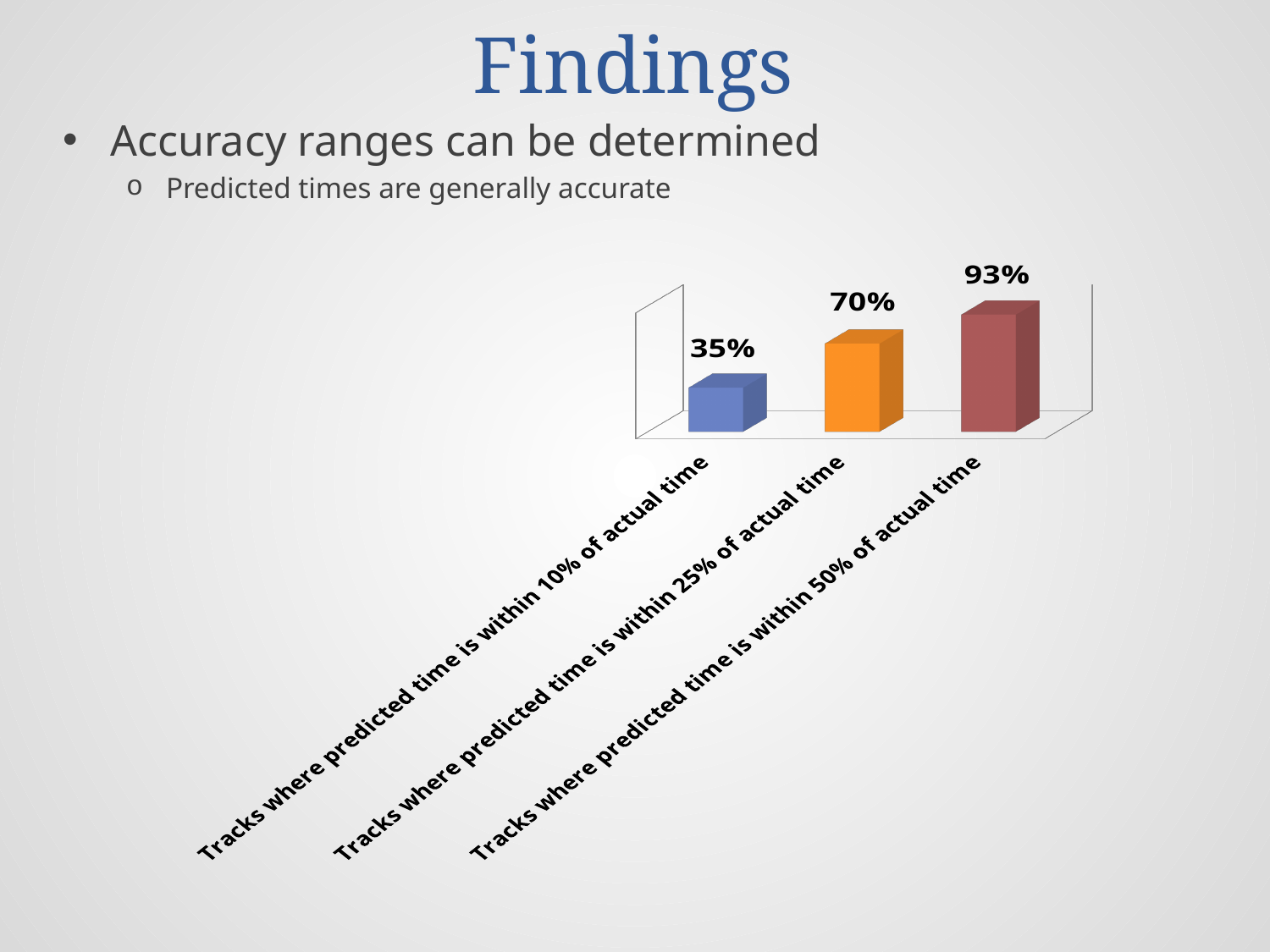
Which is larger: the value for tracks within 25% of actual time or tracks within 50% of actual time? Tracks where predicted time is within 50% of actual time Do the values rise or fall from left to right across the categories? Rise What is the difference between the value for tracks within 50% of actual time and tracks within 10% of actual time? 58% Which category has the highest value? Tracks where predicted time is within 50% of actual time Which category has the lowest value? Tracks where predicted time is within 10% of actual time How many categories are shown in the chart? 3 What is the value for tracks where predicted time is within 10% of actual time? 35% What kind of chart is shown on the slide? Bar chart What colour is the bar for tracks where predicted time is within 25% of actual time? Orange What is the value for tracks where predicted time is within 50% of actual time? 93% What is the difference between the value for tracks within 25% of actual time and tracks within 10% of actual time? 35% What is the value for tracks where predicted time is within 25% of actual time? 70%